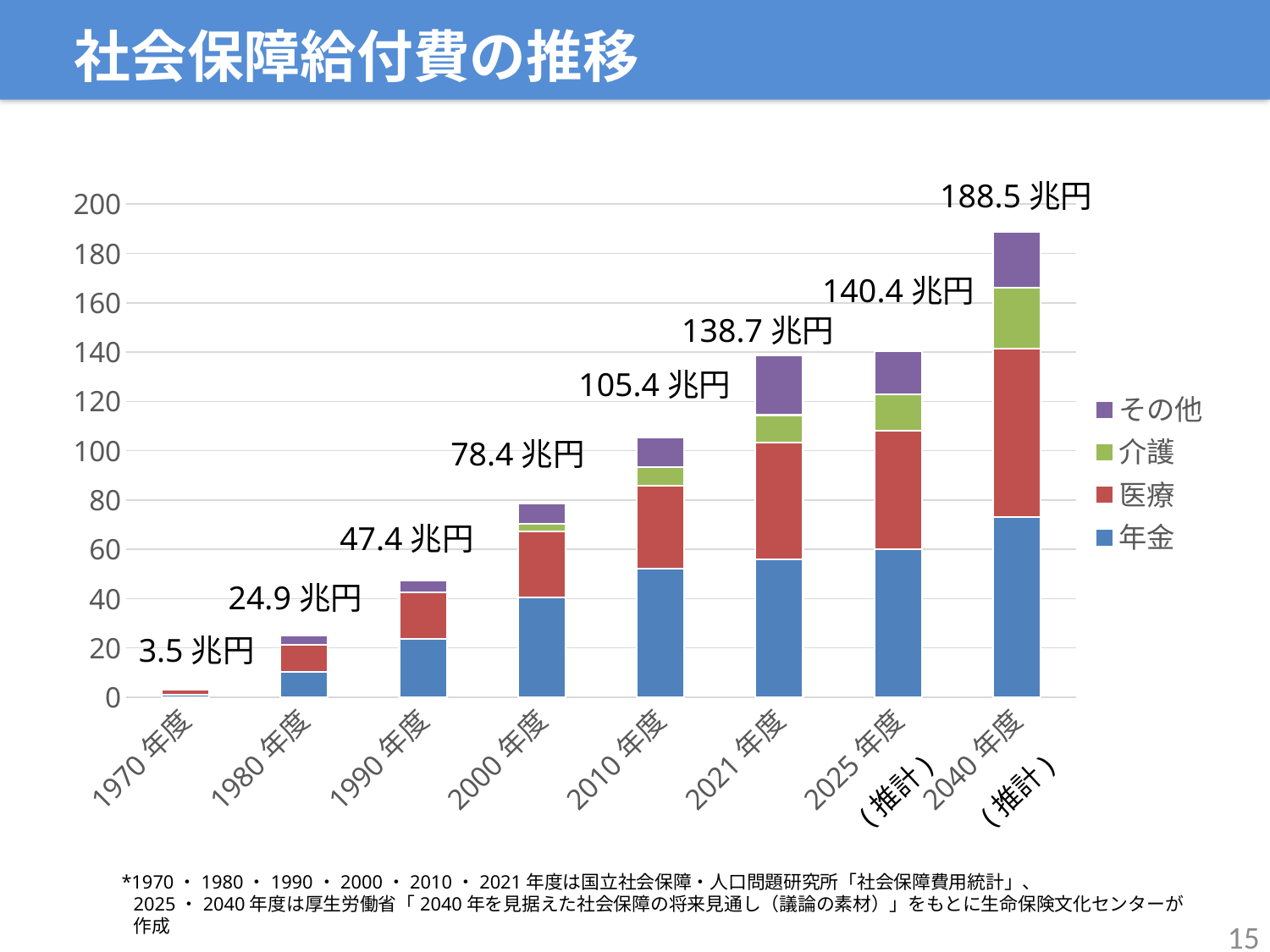
What is the difference between the total for 2040年度（推計） and the total for 2025年度（推計）? 48.1 兆円 Which fiscal year has the highest total social security benefit expenditure? 2040年度（推計） Do the total values rise or fall from 1970年度 to 2040年度（推計）? Rise What is the total value labeled for 2000年度? 78.4 兆円 How many series does the legend list? 4 Which fiscal year has the lowest total social security benefit expenditure? 1970年度 What kind of chart is shown on the slide? Stacked bar chart Is the 年金 segment for 2040年度（推計） greater or less than 60? greater What is the total value labeled for 1980年度? 24.9 兆円 What is the total social security benefit expenditure shown for 2040年度（推計）? 188.5 兆円 Which is larger, the total for 2010年度 or the total for 2021年度? 2021年度 How many fiscal years are shown on the x axis? 8